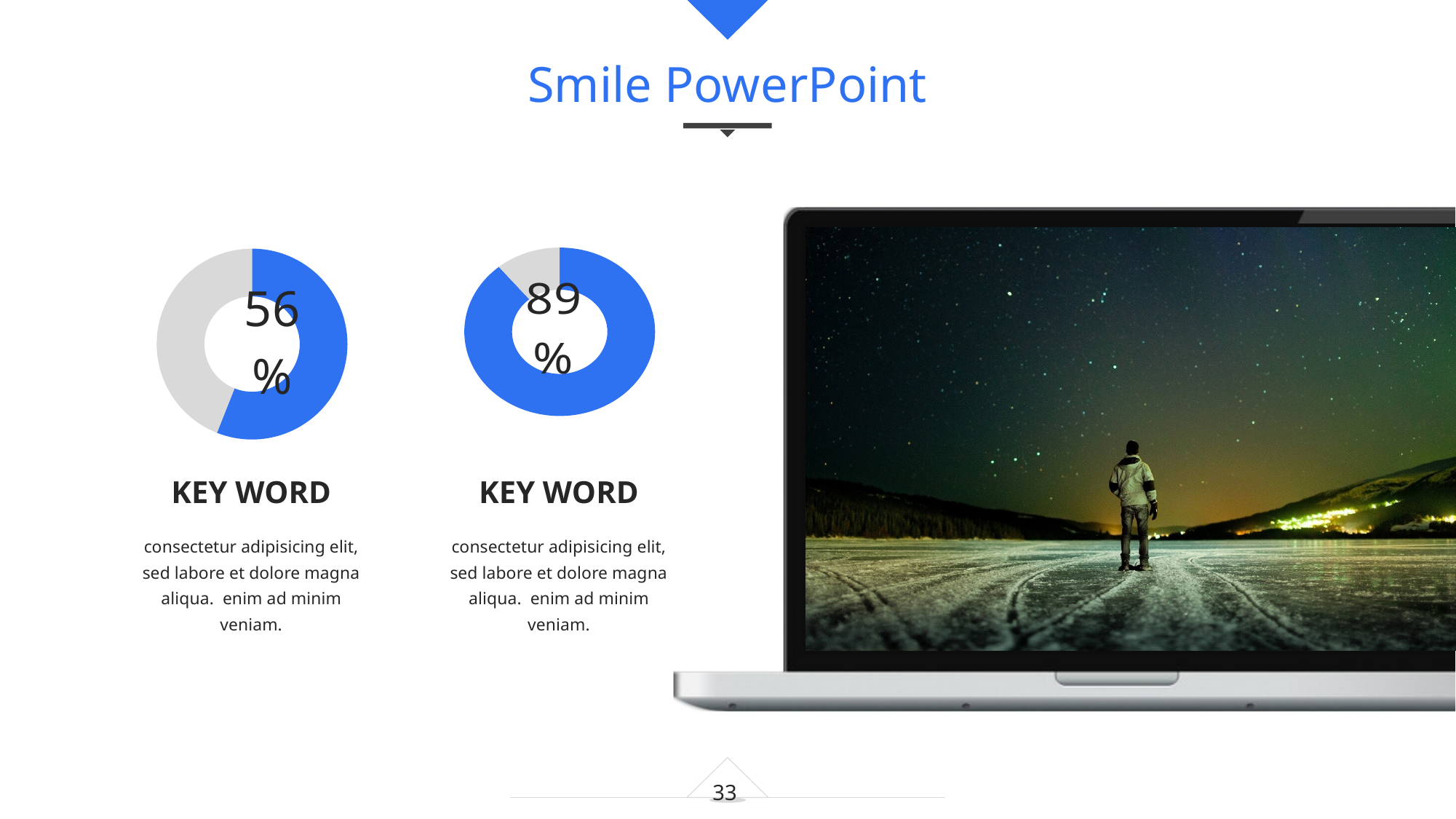
What value is shown in the centre of the right donut chart? 89% What is the difference between the percentage in the right donut chart and the percentage in the left donut chart? 33 percentage points What kind of chart is used in the middle of the slide, to the right of the first chart? Donut chart In the right donut chart, what colour is the larger slice? Blue What value is shown in the centre of the left donut chart? 56% How many slices does the right donut chart have? 2 In the left donut chart, what share of the ring is filled in blue? 56% How many donut charts are on the slide? 2 What kind of chart is used on the left side of the slide? Donut chart What label appears below each donut chart? KEY WORD How many slices does the left donut chart have? 2 Which donut chart shows the larger percentage, the left one or the right one? The right one